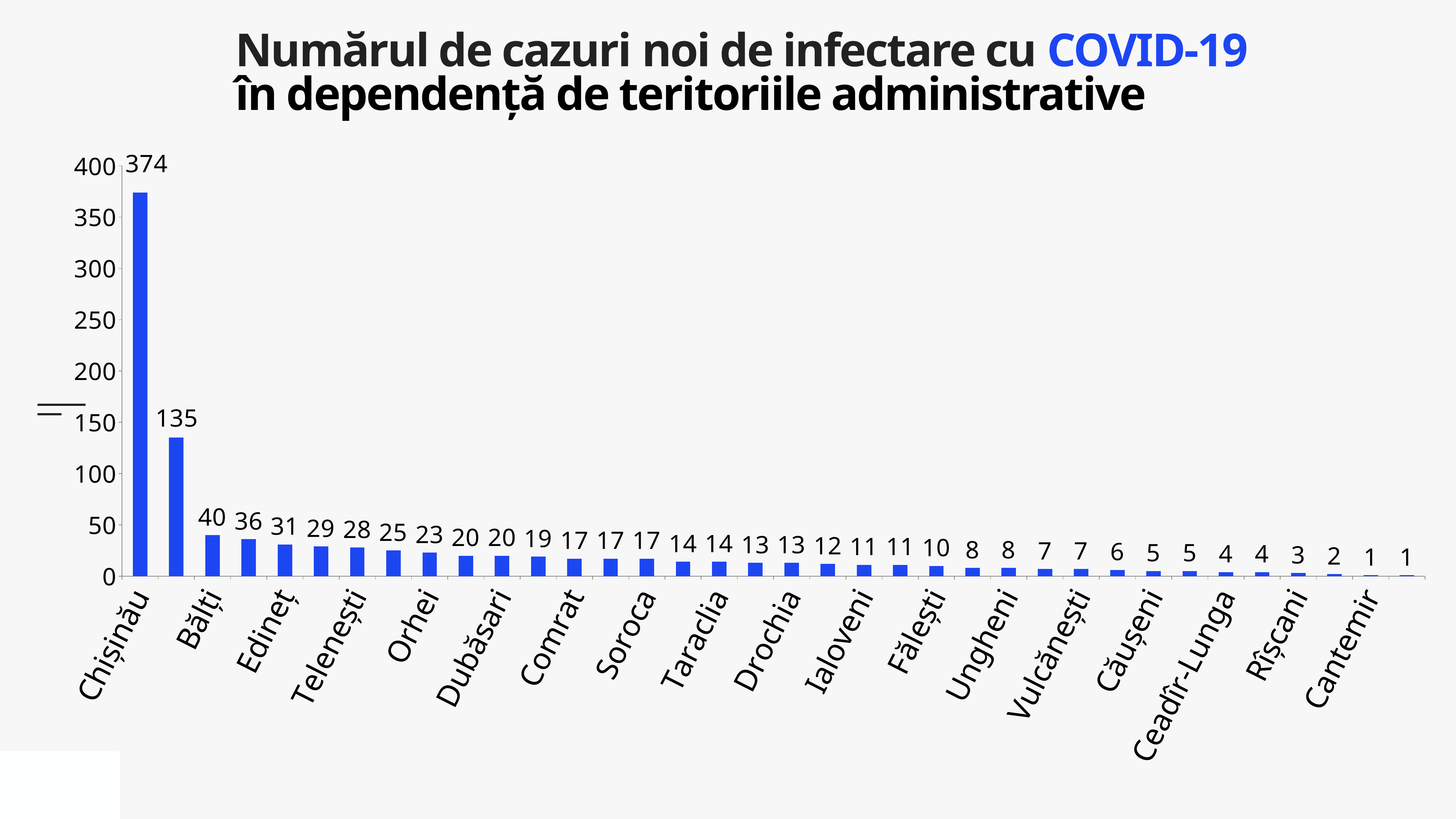
What is the highest value shown on the chart? 374 What is the second highest value shown on the chart? 135 Do the values rise or fall from left to right along the x axis? fall What type of chart is shown on the slide? bar chart What is the lowest value shown on the chart? 1 What is the number of new cases shown for Chișinău? 374 What is the highest tick value shown on the vertical axis? 400 How many bars are plotted on the chart? 36 What colour are the bars on the chart? blue Is the value for Chișinău greater or less than 350? greater Which territory has the highest number of new COVID-19 cases? Chișinău Which has more new cases, Chișinău or Bălți? Chișinău